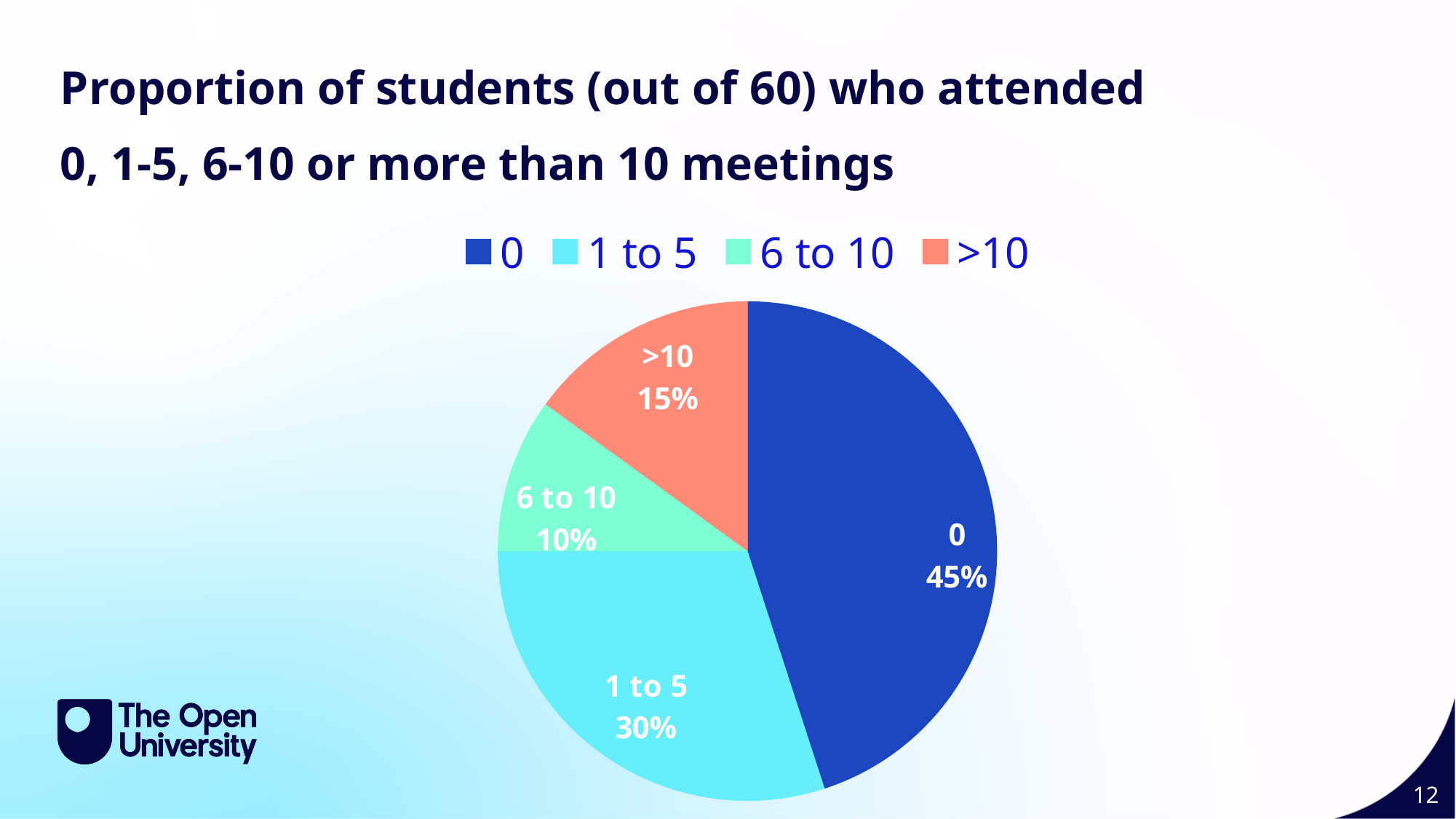
What percentage of students attended 0 meetings? 45% Which category has the largest share of the pie? 0 How many slices does the pie chart have? 4 What colour is the slice for 1 to 5 meetings? light blue (cyan) Which slice is larger: >10 or 6 to 10? >10 What percentage of students attended 1 to 5 meetings? 30% What kind of chart is shown on the slide? pie chart Which category has the smallest share of the pie? 6 to 10 What is the difference in percentage points between the 0 slice and the 1 to 5 slice? 15 How many entries does the legend list? 4 What percentage of students attended 6 to 10 meetings? 10% What percentage of students attended more than 10 meetings? 15%